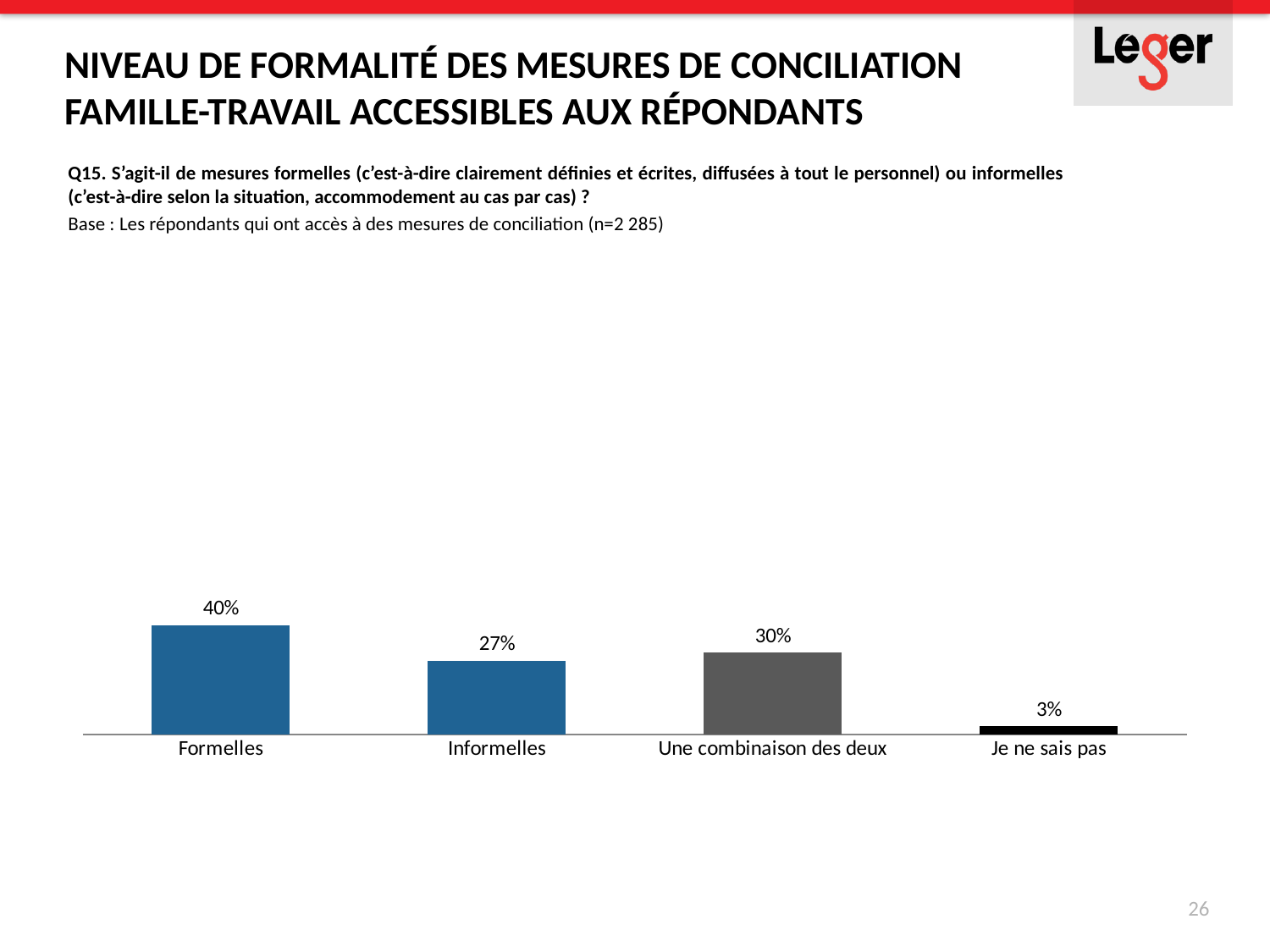
What is the difference between the values for Formelles and Informelles? 13% Which is larger, the value for Informelles or the value for Une combinaison des deux? Une combinaison des deux What kind of chart is shown on the slide? Bar chart Which category has the highest value? Formelles What is the value for Une combinaison des deux? 30% What is the difference between the values for Une combinaison des deux and Je ne sais pas? 27% What is the value for Je ne sais pas? 3% What colour is the bar for Une combinaison des deux? Grey Which category has the lowest value? Je ne sais pas What is the value for Informelles? 27% How many categories are shown in the chart? 4 What is the value for Formelles? 40%